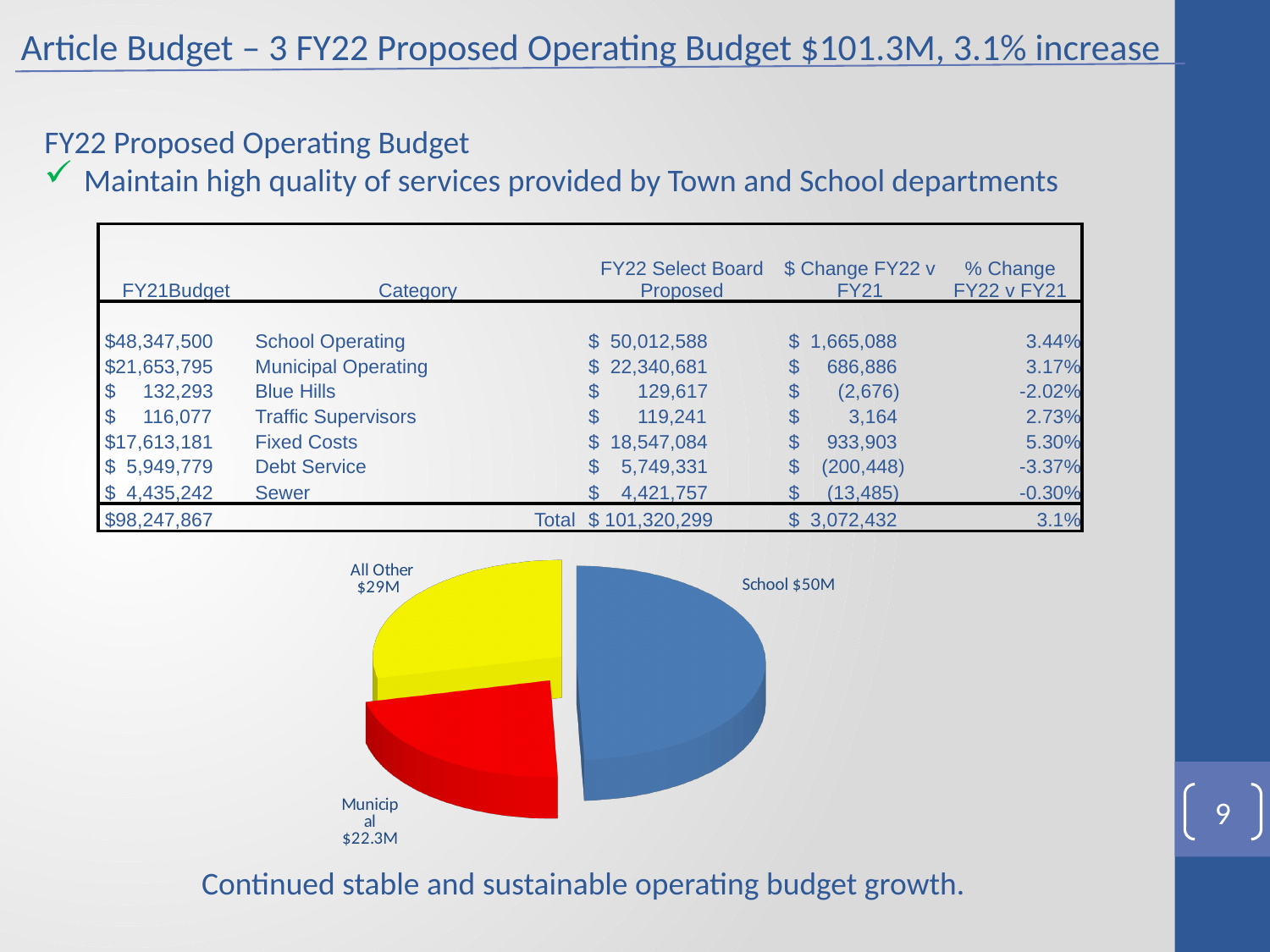
What colour is the Municipal slice in the pie chart? red What is the value shown for the School slice of the pie chart? $50M What is the difference between the All Other slice and the Municipal slice in the pie chart? $6.7M How many slices does the pie chart have? 3 What is the value shown for the Municipal slice of the pie chart? $22.3M Which slice of the pie chart is the smallest? Municipal Which slice of the pie chart is the largest? School What kind of chart is shown on the slide? pie chart In the pie chart, which is larger, All Other or Municipal? All Other What is the difference between the School slice and the Municipal slice in the pie chart? $27.7M What colour is the School slice in the pie chart? blue What is the value shown for the All Other slice of the pie chart? $29M